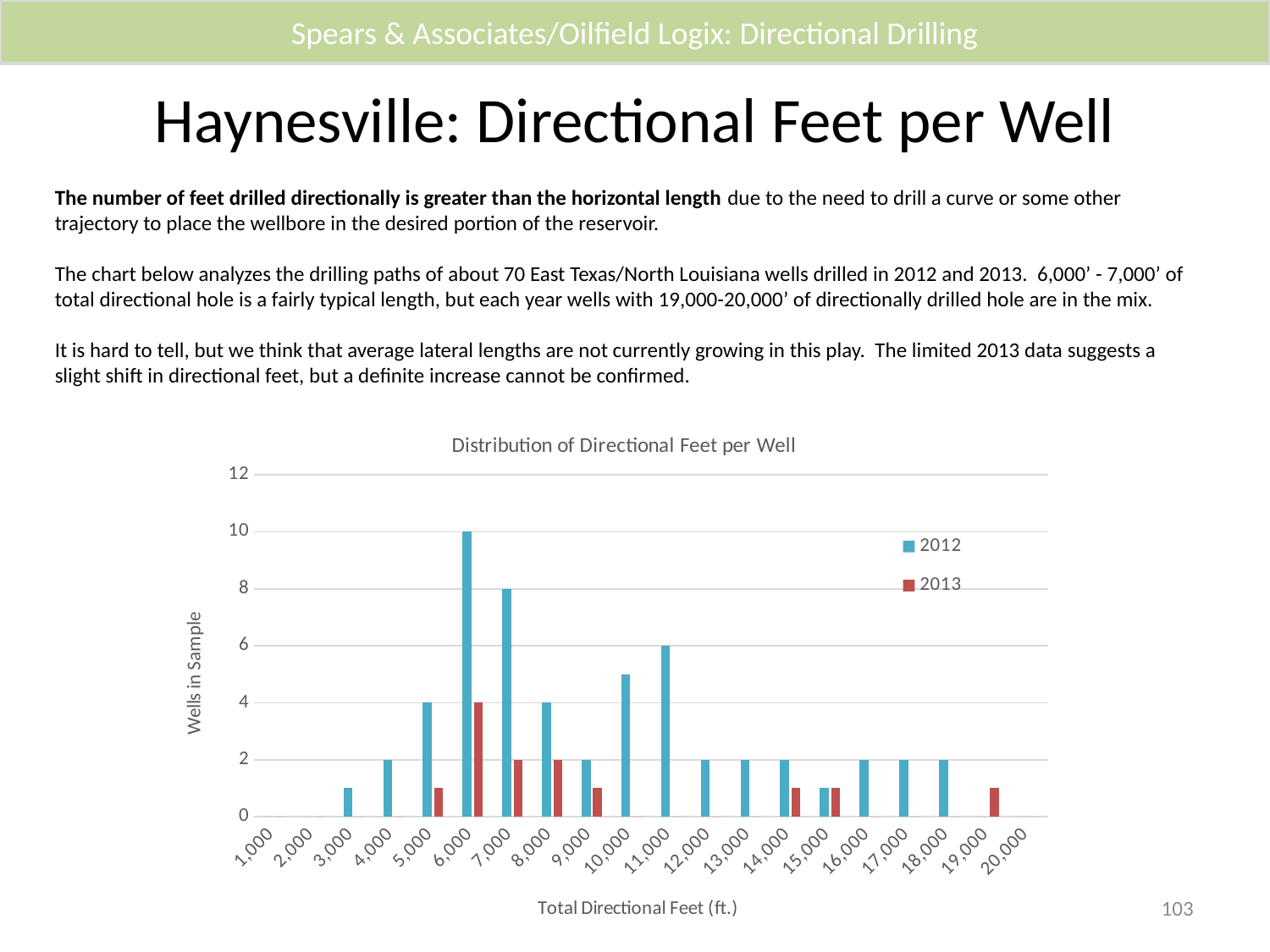
What kind of chart is shown on the slide? bar chart How many series does the chart legend list? 2 Which is larger in the 7,000 category, the 2012 value or the 2013 value? 2012 How many wells in the 2012 series fall in the 6,000 category? 10 What is the title of the chart? Distribution of Directional Feet per Well Is the 2012 value for the 10,000 category greater or less than 4? greater Which category has the highest value for the 2012 series? 6,000 How many wells in the 2012 series fall in the 7,000 category? 8 How many wells in the 2012 series fall in the 11,000 category? 6 What is the difference between the 2012 and 2013 values in the 6,000 category? 6 How many categories are shown on the x axis of the chart? 20 How many wells in the 2013 series fall in the 6,000 category? 4